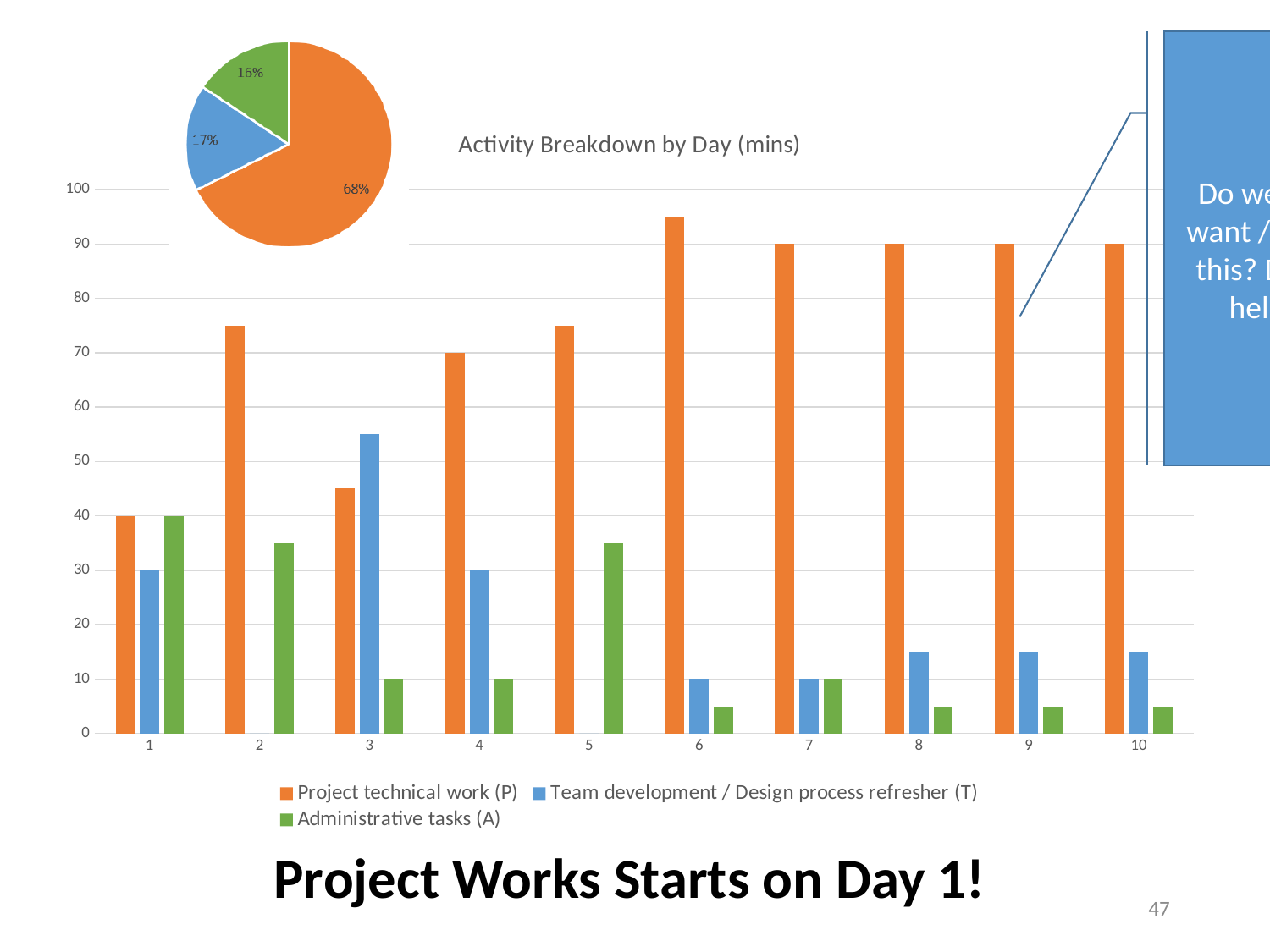
In the 'Activity Breakdown by Day (mins)' chart, on which day is Project technical work (P) highest? 6 In the 'Activity Breakdown by Day (mins)' chart, what is the value of Team development / Design process refresher (T) on day 1? 30 In the 'Activity Breakdown by Day (mins)' chart, is the value of Project technical work (P) on day 2 greater or less than 70? greater What kind of chart is 'Activity Breakdown by Day (mins)'? bar chart In the 'Activity Breakdown by Day (mins)' chart, is the value of Team development / Design process refresher (T) on day 3 greater or less than 50? greater In the 'Activity Breakdown by Day (mins)' chart, what is the value of Project technical work (P) on day 4? 70 How many series does the legend of the 'Activity Breakdown by Day (mins)' chart list? 3 In the 'Activity Breakdown by Day (mins)' chart, what is the value of Project technical work (P) on day 7? 90 In the 'Activity Breakdown by Day (mins)' chart, on day 3, which is larger: Project technical work (P) or Team development / Design process refresher (T)? Team development / Design process refresher (T) In the 'Activity Breakdown by Day (mins)' chart, what is the difference between Project technical work (P) on day 7 and on day 4? 20 In the 'Activity Breakdown by Day (mins)' chart, how many days are shown on the x axis? 10 In the pie chart at the top left of the slide, what percentage does the largest (orange) slice show? 68%